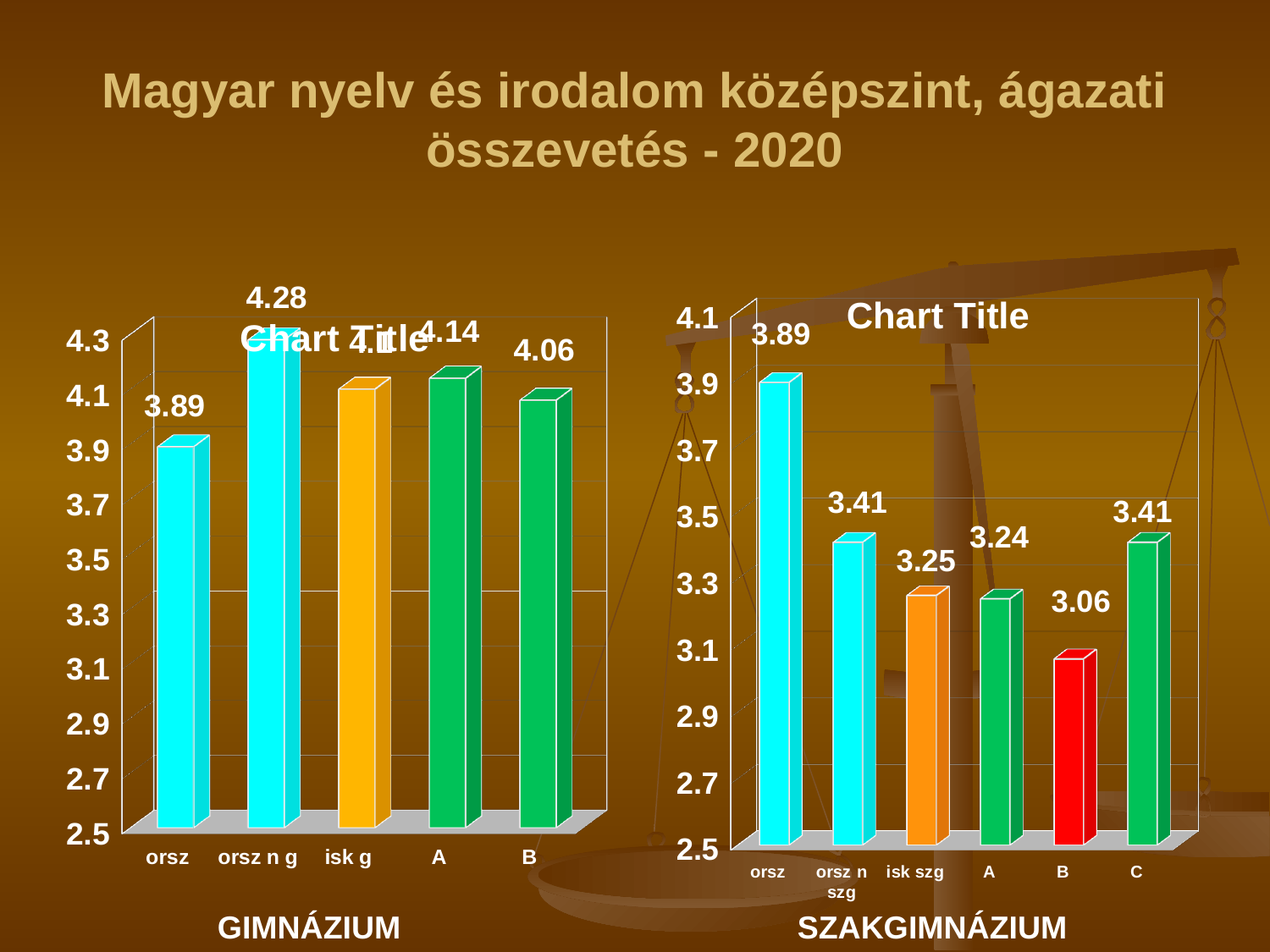
In the left chart (GIMNÁZIUM), what is the difference between orsz n g and A? 0.14 In the left chart (GIMNÁZIUM), what is the value for B? 4.06 In the left chart (GIMNÁZIUM), which category has the lowest value? orsz In the left chart (GIMNÁZIUM), which category has the highest value? orsz n g In the left chart (GIMNÁZIUM), how many categories are shown? 5 In the right chart (SZAKGIMNÁZIUM), what is the value for isk szg? 3.25 In the right chart (SZAKGIMNÁZIUM), what is the difference between orsz and B? 0.83 In the right chart (SZAKGIMNÁZIUM), which is larger, orsz n szg or A? orsz n szg What kind of chart is the right chart (SZAKGIMNÁZIUM)? bar chart In the right chart (SZAKGIMNÁZIUM), which category has the lowest value? B In the left chart (GIMNÁZIUM), what is the value for orsz? 3.89 In the right chart (SZAKGIMNÁZIUM), what is the value for B? 3.06